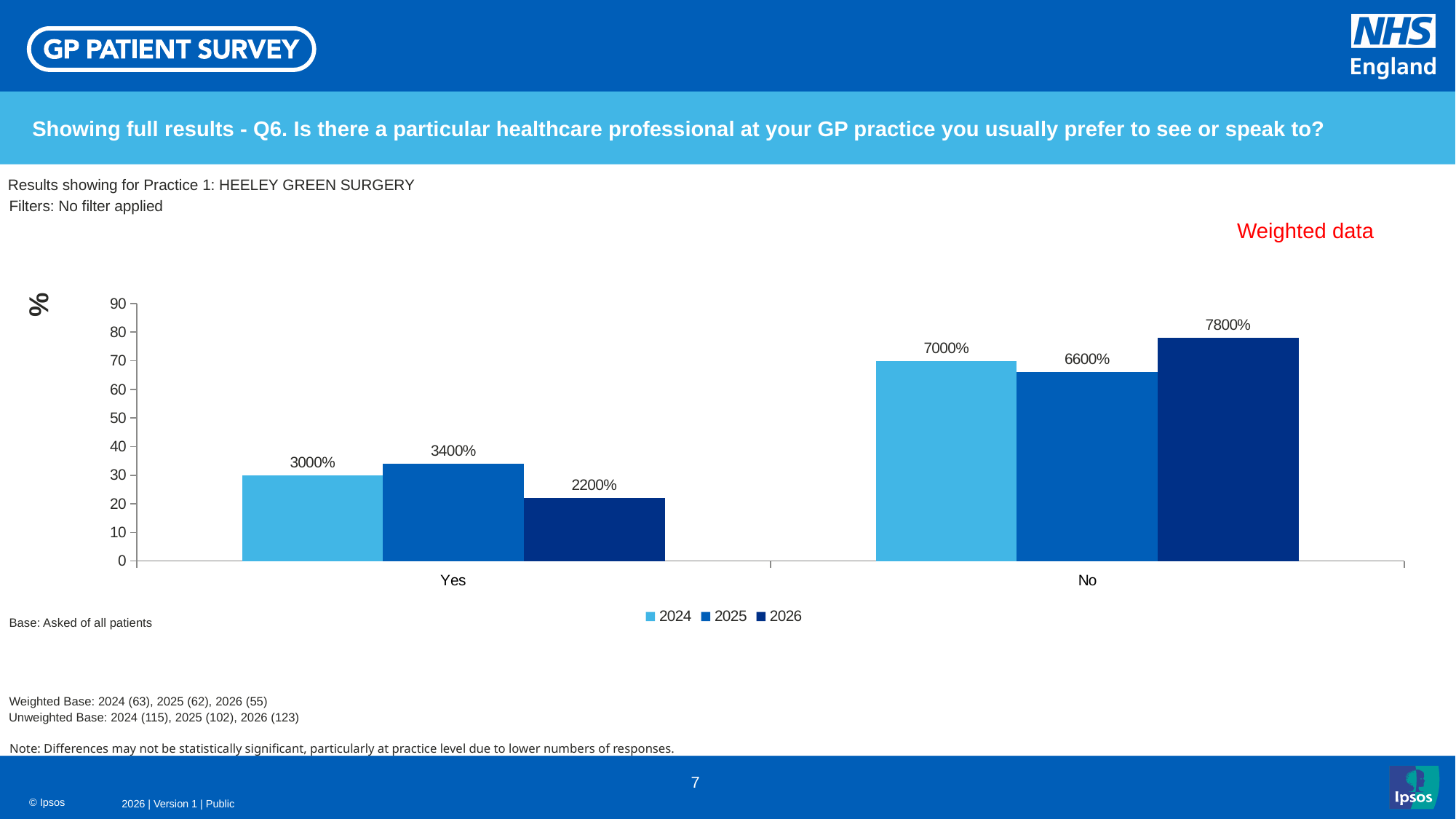
Which practice are the results shown for? HEELEY GREEN SURGERY Which year has the highest value in the No category? 2026 Which is larger: the 2025 value for Yes or the 2025 value for No? No What is the difference between the 2026 and 2024 values in the No category? 800% What is the value for 2024 in the Yes category? 3000% How many series does the legend list? 3 What is the value for 2025 in the Yes category? 3400% What kind of chart is shown on the slide? bar chart Which year has the lowest value in the Yes category? 2026 Is the 2026 bar for Yes greater or less than 30 on the axis? less What is the value for 2026 in the No category? 7800% How many categories are shown on the x axis? 2